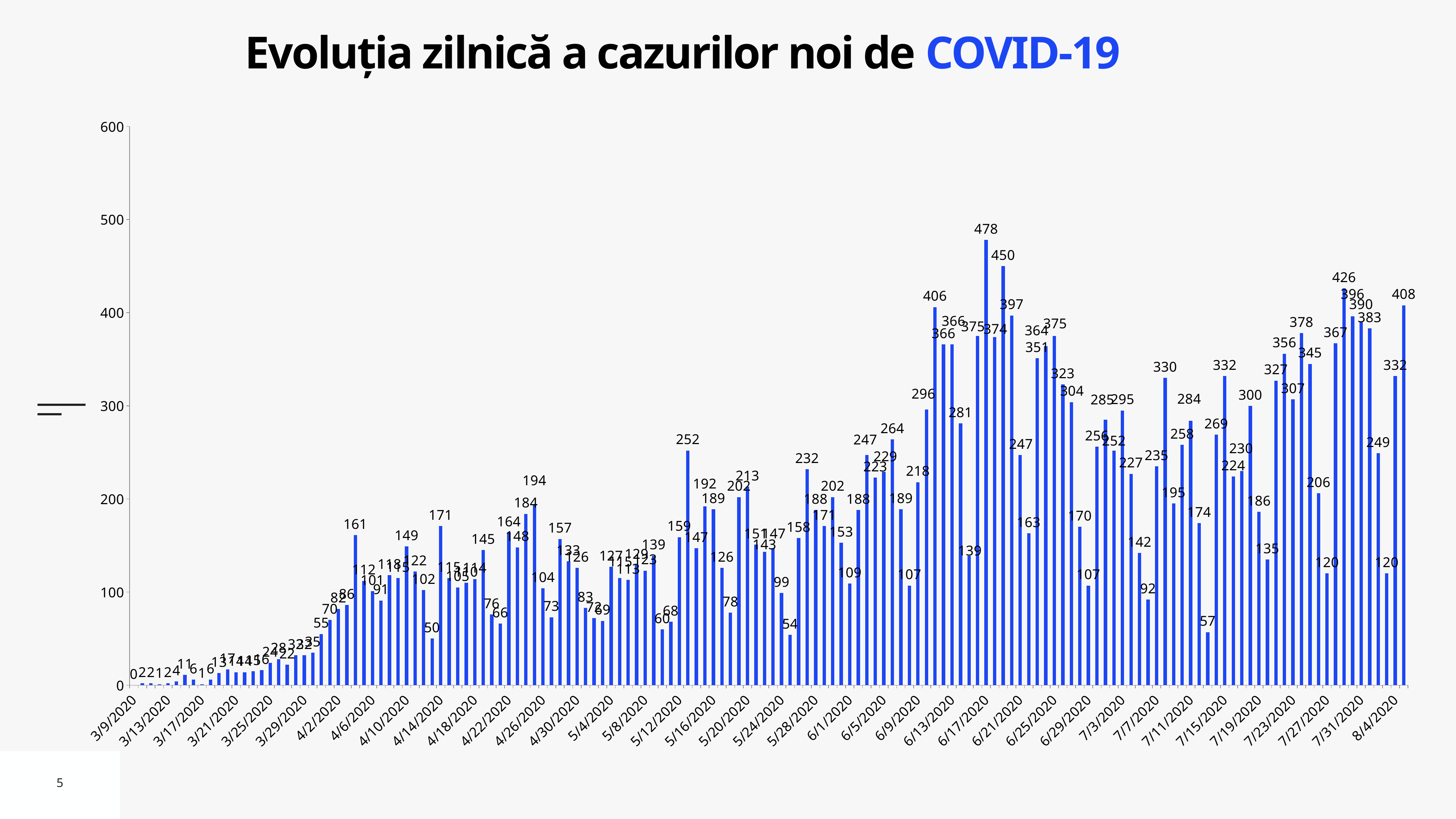
Is the value for 8/4/2020 greater or less than 400? less What is the difference between the two highest values, 478 and 450? 28 What is the value for the last date on the x axis, 8/4/2020? 332 What is the value for the first date on the x axis, 3/9/2020? 0 What is the highest daily value shown in the chart? 478 What kind of chart is shown on the slide? bar chart What is the title of the chart? Evoluția zilnică a cazurilor noi de COVID-19 Overall, do the daily values rise or fall from March to August along the x axis? rise What is the maximum value shown on the vertical axis? 600 Which is larger, the peak value of 478 or the value of 450 next to it? 478 What is the lowest daily value shown in the chart? 0